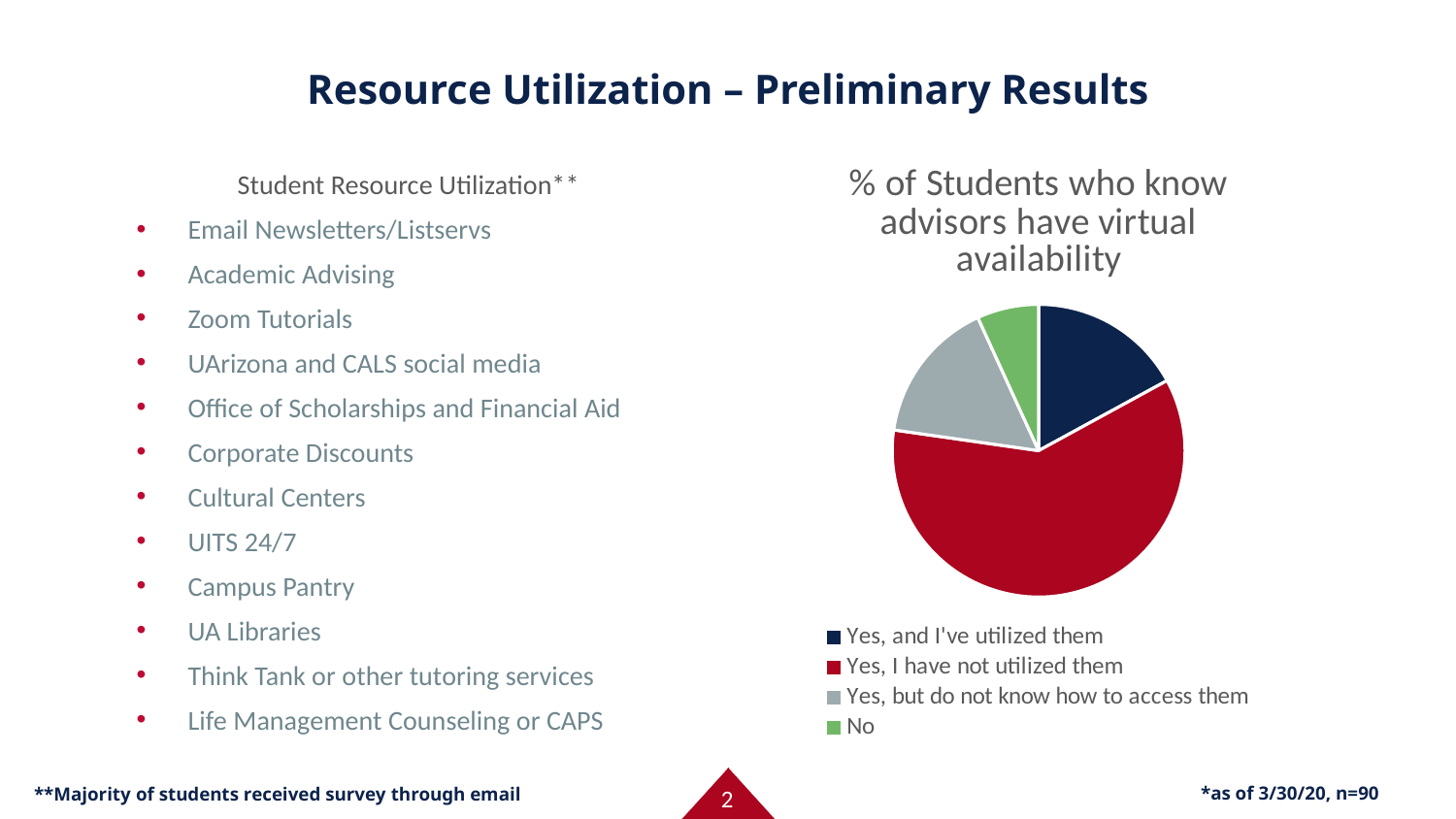
What kind of chart is shown on the slide? pie chart Which slice is larger: "Yes, I have not utilized them" or "Yes, and I've utilized them"? Yes, I have not utilized them How many entries does the pie chart's legend list? 4 Which category has the largest slice of the pie chart? Yes, I have not utilized them Which legend entry is shown in green in the pie chart? No Which category has the smallest slice of the pie chart? No How many slices does the pie chart have? 4 Which slice is larger: "Yes, I have not utilized them" or "Yes, but do not know how to access them"? Yes, I have not utilized them What is the title of the pie chart? % of Students who know advisors have virtual availability Which slice is larger: "Yes, but do not know how to access them" or "No"? Yes, but do not know how to access them